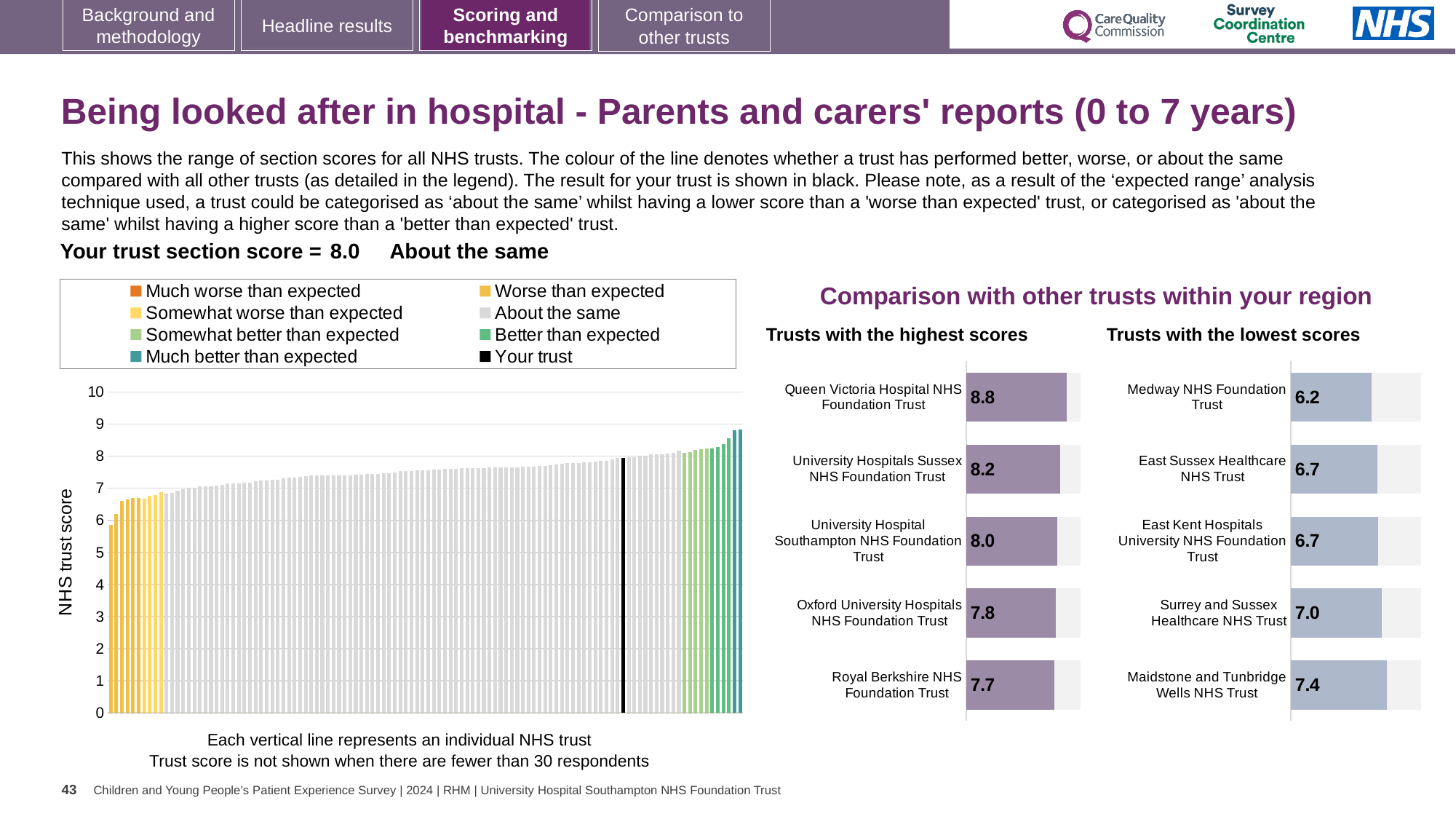
In the 'Trusts with the highest scores' chart, what is the score for Queen Victoria Hospital NHS Foundation Trust? 8.8 What kind of chart is the large chart on the left showing NHS trust scores? Bar chart How many entries does the legend of the large chart on the left list? 8 How many trusts are shown in the 'Trusts with the highest scores' chart? 5 In the large chart on the left, do the NHS trust scores rise or fall from left to right? Rise In the 'Trusts with the highest scores' chart, what is the difference between the scores of Queen Victoria Hospital NHS Foundation Trust and Royal Berkshire NHS Foundation Trust? 1.1 In the 'Trusts with the lowest scores' chart, which trust has the lowest score? Medway NHS Foundation Trust In the 'Trusts with the lowest scores' chart, which has the larger score: Medway NHS Foundation Trust or Surrey and Sussex Healthcare NHS Trust? Surrey and Sussex Healthcare NHS Trust In the 'Trusts with the lowest scores' chart, what is the score for Medway NHS Foundation Trust? 6.2 In the 'Trusts with the highest scores' chart, which trust has the highest score? Queen Victoria Hospital NHS Foundation Trust In the 'Trusts with the highest scores' chart, what is the score for Oxford University Hospitals NHS Foundation Trust? 7.8 In the 'Trusts with the lowest scores' chart, what is the score for Maidstone and Tunbridge Wells NHS Trust? 7.4